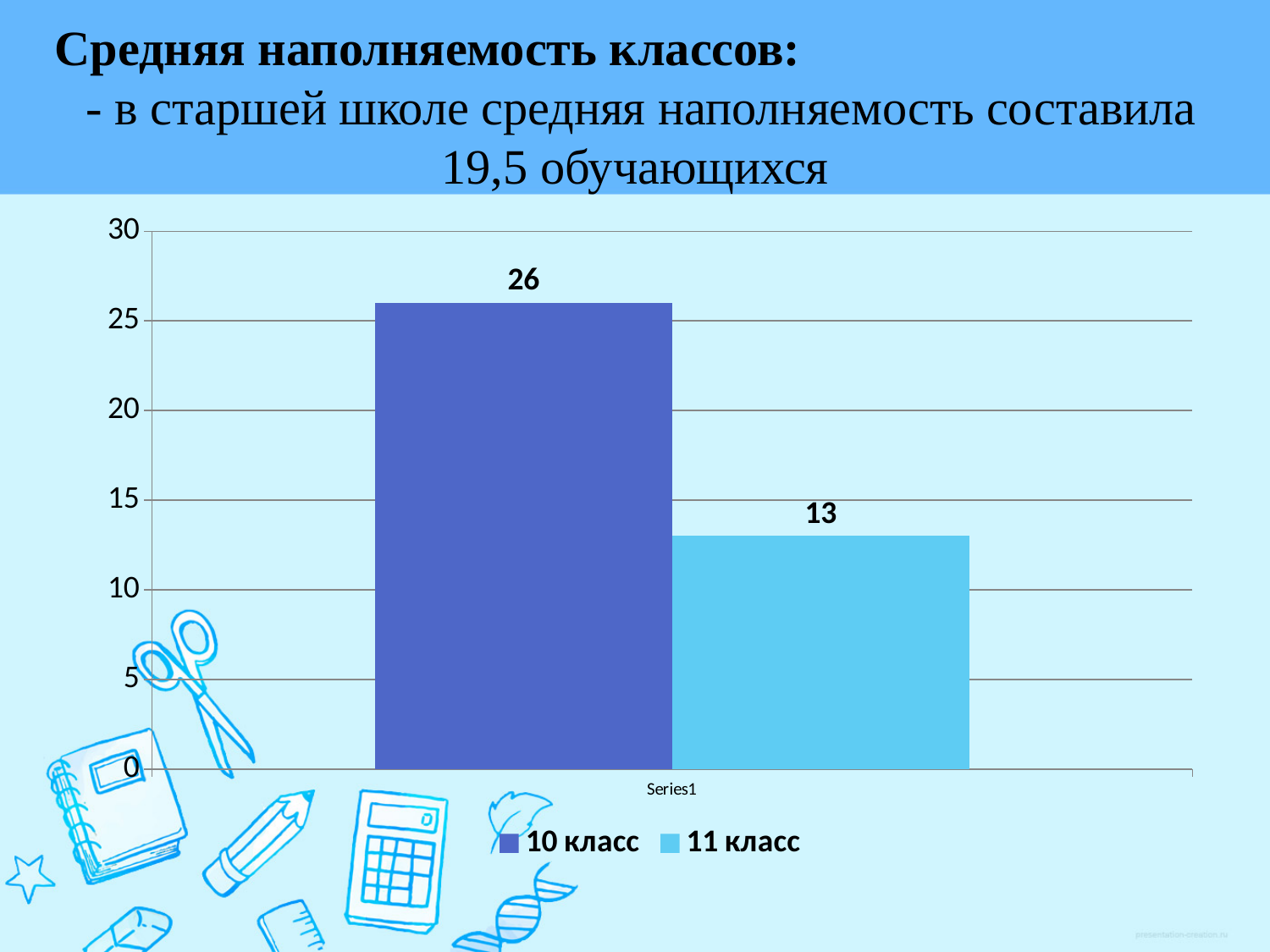
How many series does the legend list? 2 What is the difference between the values for 10 класс and 11 класс? 13 Which series has the highest value? 10 класс Is the value for 10 класс greater or less than 25? greater What is the value for 10 класс? 26 Which is larger, the value for 10 класс or the value for 11 класс? 10 класс What is the highest value shown on the y axis? 30 What kind of chart is shown on the slide? bar chart What is the value for 11 класс? 13 Is the value for 11 класс greater or less than 15? less What is the category label shown on the x axis? Series1 Which series has the lowest value? 11 класс